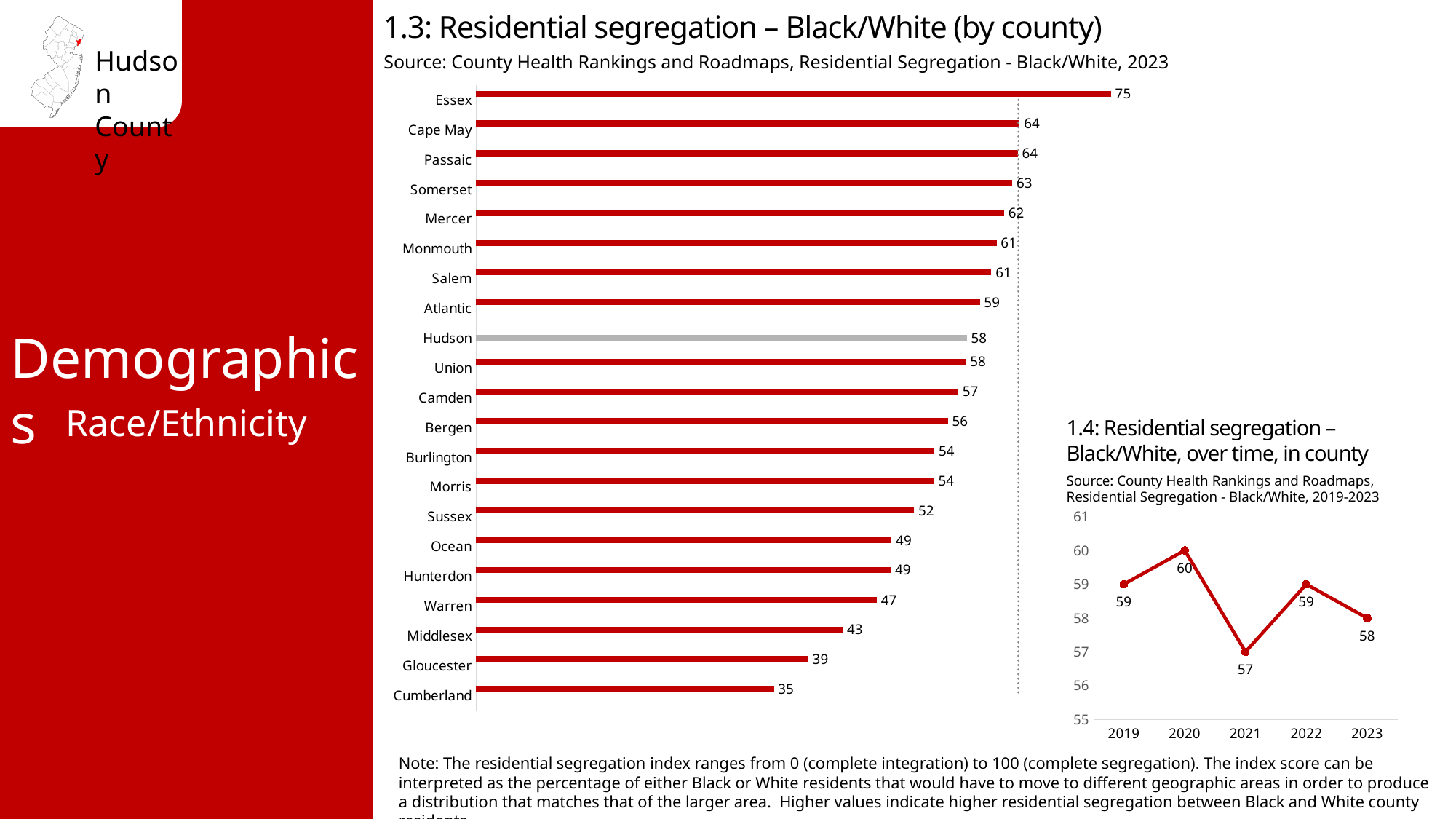
In chart 1.4 (over time), which year has the highest value? 2020 In chart 1.3 (by county), what is the value for Gloucester? 39 In chart 1.3 (by county), which county has the highest residential segregation index? Essex What kind of chart is chart 1.4 (Residential segregation over time, in county)? Line chart In chart 1.3 (Residential segregation – Black/White by county), what is the value for Hudson? 58 In chart 1.4 (over time), how many data points are plotted? 5 In chart 1.3 (by county), which has a higher value, Bergen or Middlesex? Bergen In chart 1.3 (by county), how many counties are shown? 21 What kind of chart is chart 1.3 (Residential segregation – Black/White by county)? Bar chart In chart 1.3 (by county), which county has the lowest residential segregation index? Cumberland In chart 1.3 (by county), what is the difference between the values for Essex and Cumberland? 40 In chart 1.4 (Residential segregation over time, in county), what is the value for 2021? 57